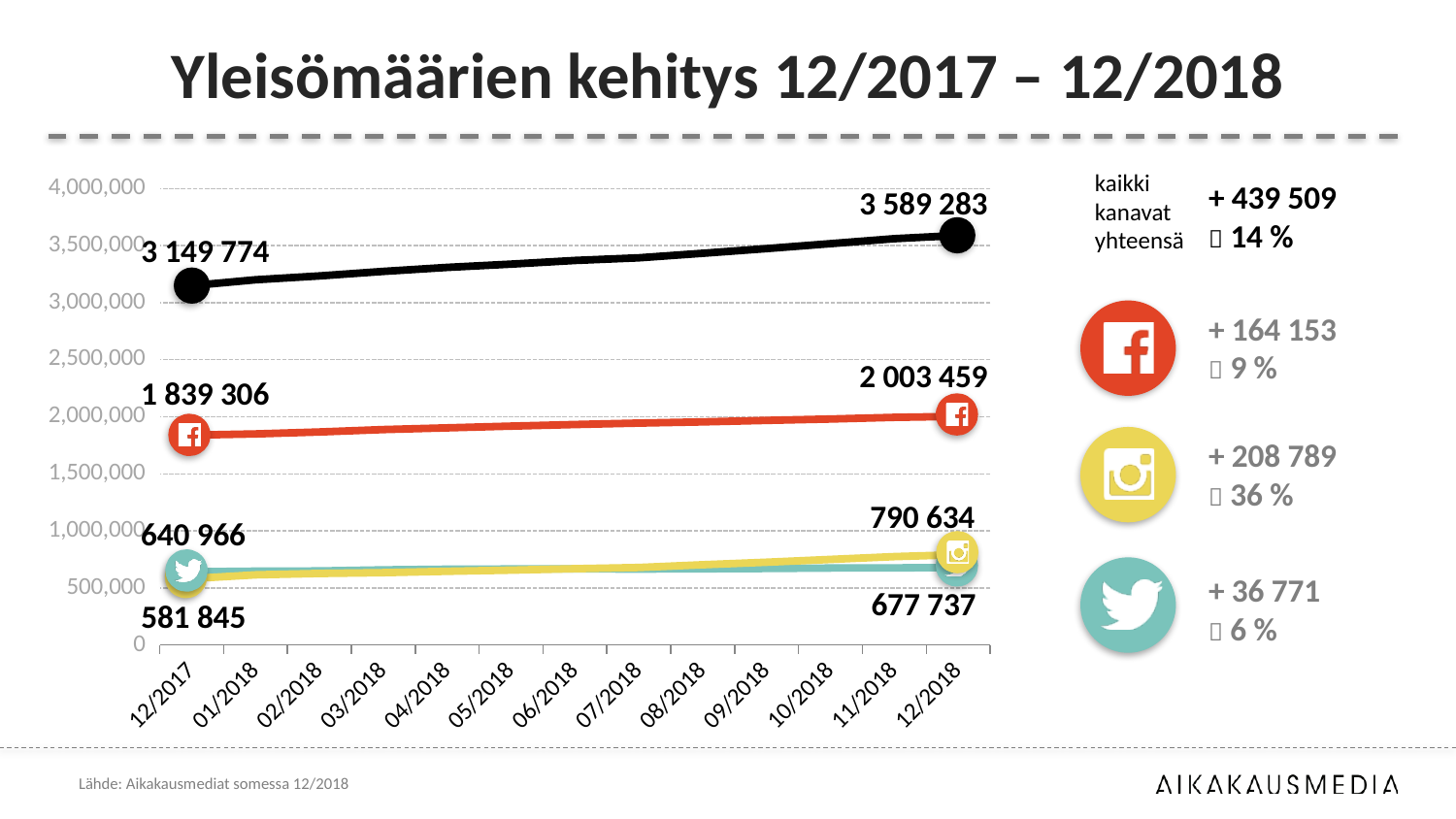
By how much did the Facebook value grow from 12/2017 to 12/2018? 164 153 Is the Facebook value at 12/2018 greater or less than 2,000,000? greater By how much did the total (black line) grow from 12/2017 to 12/2018? 439 509 What is the Facebook value at 12/2018? 2 003 459 What kind of chart is shown on the slide? Line chart What is the value of the black (total) line at 12/2017? 3 149 774 What is the Facebook value at 12/2017? 1 839 306 What is the Twitter value at 12/2018? 677 737 What is the value of the black (total) line at 12/2018? 3 589 283 Which is larger at 12/2018, the Instagram value or the Twitter value? Instagram What is the Instagram value at 12/2018? 790 634 How many months are shown on the x axis? 13